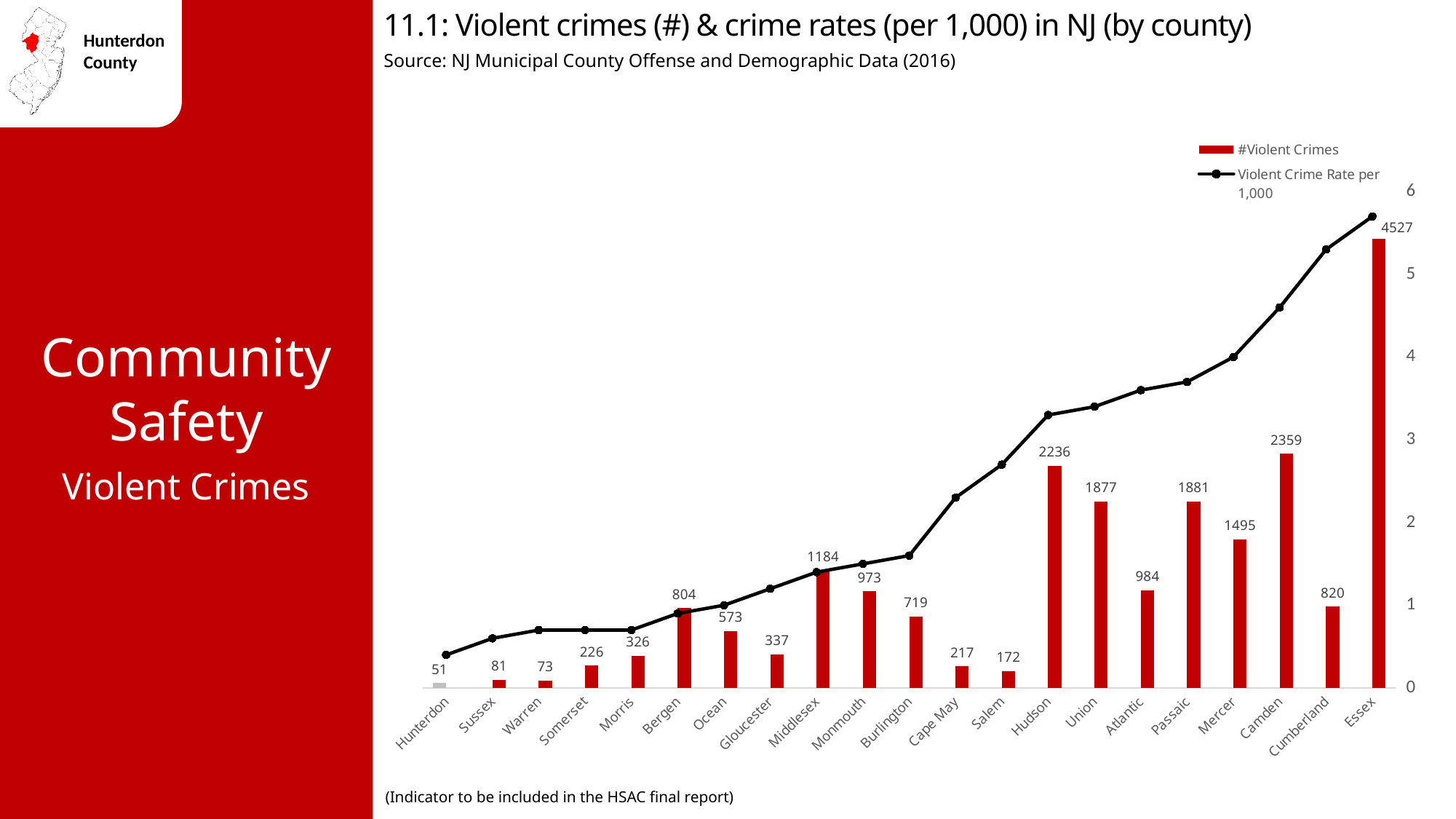
Does the violent crime rate per 1,000 line generally rise or fall from Hunterdon to Essex? rise Is the violent crime rate per 1,000 for Hunterdon greater or less than 1? less Which county has more violent crimes, Union or Passaic? Passaic Which county has the highest number of violent crimes? Essex What colour are the bars representing the number of violent crimes? Red Which county has the lowest number of violent crimes? Hunterdon How many series does the chart legend list? 2 What is the difference in the number of violent crimes between Essex and Camden? 2168 What is the number of violent crimes for Hudson County? 2236 Is the violent crime rate per 1,000 for Essex greater or less than 5? greater How many counties are shown on the x axis of the chart? 21 How many violent crimes are shown for Hunterdon County? 51